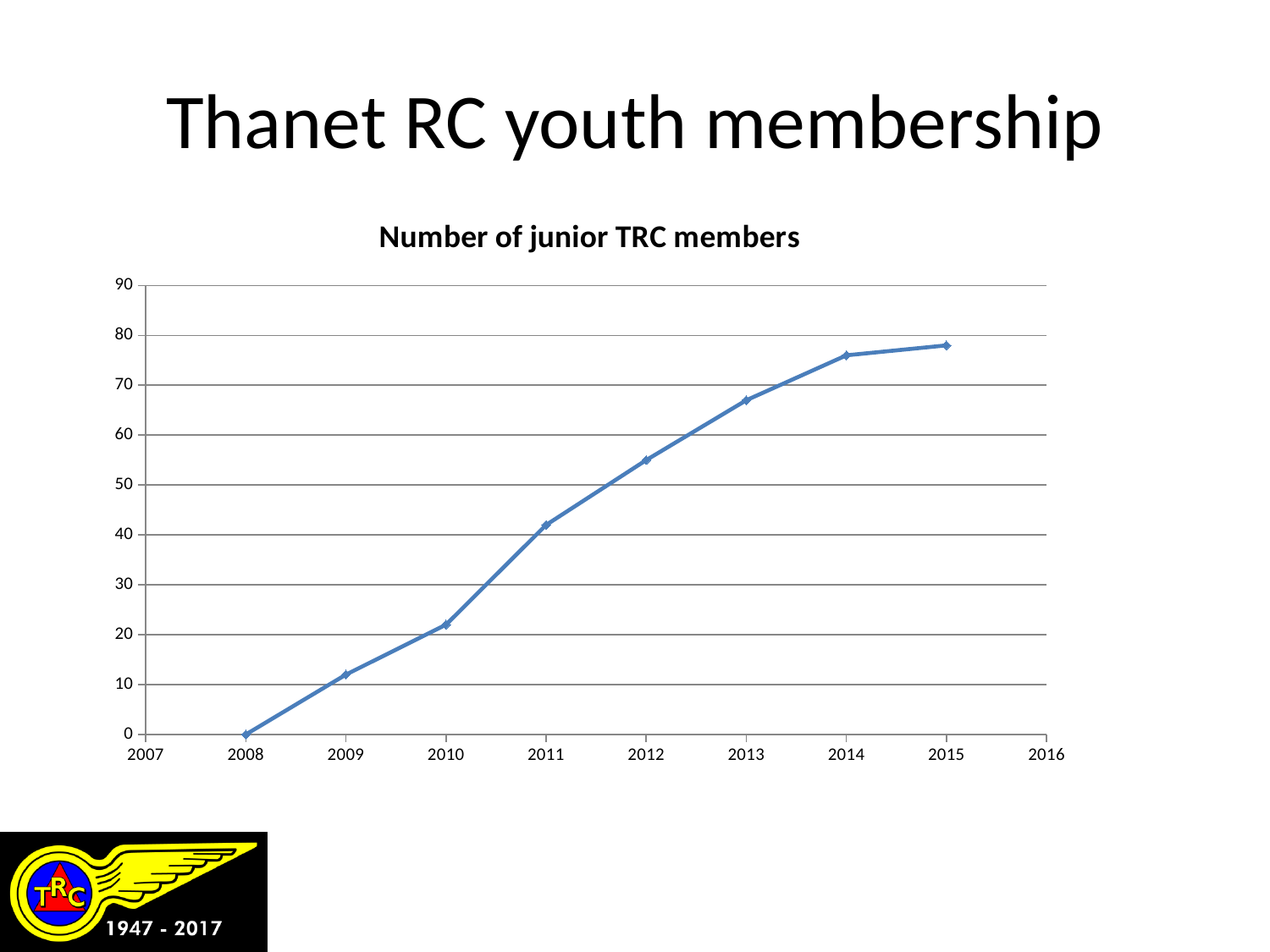
Is the value for 2013 greater or less than 60? greater Is the value for 2009 greater or less than 20? less Is the value for 2010 greater or less than 30? less What is the title of the chart? Number of junior TRC members How many data points are plotted on the line? 8 Which year has the larger value, 2011 or 2013? 2013 Which year has the lowest number of junior TRC members? 2008 Do the values rise or fall from 2008 to 2015? rise What is the number of junior TRC members in 2008? 0 What kind of chart is shown on the slide? line chart